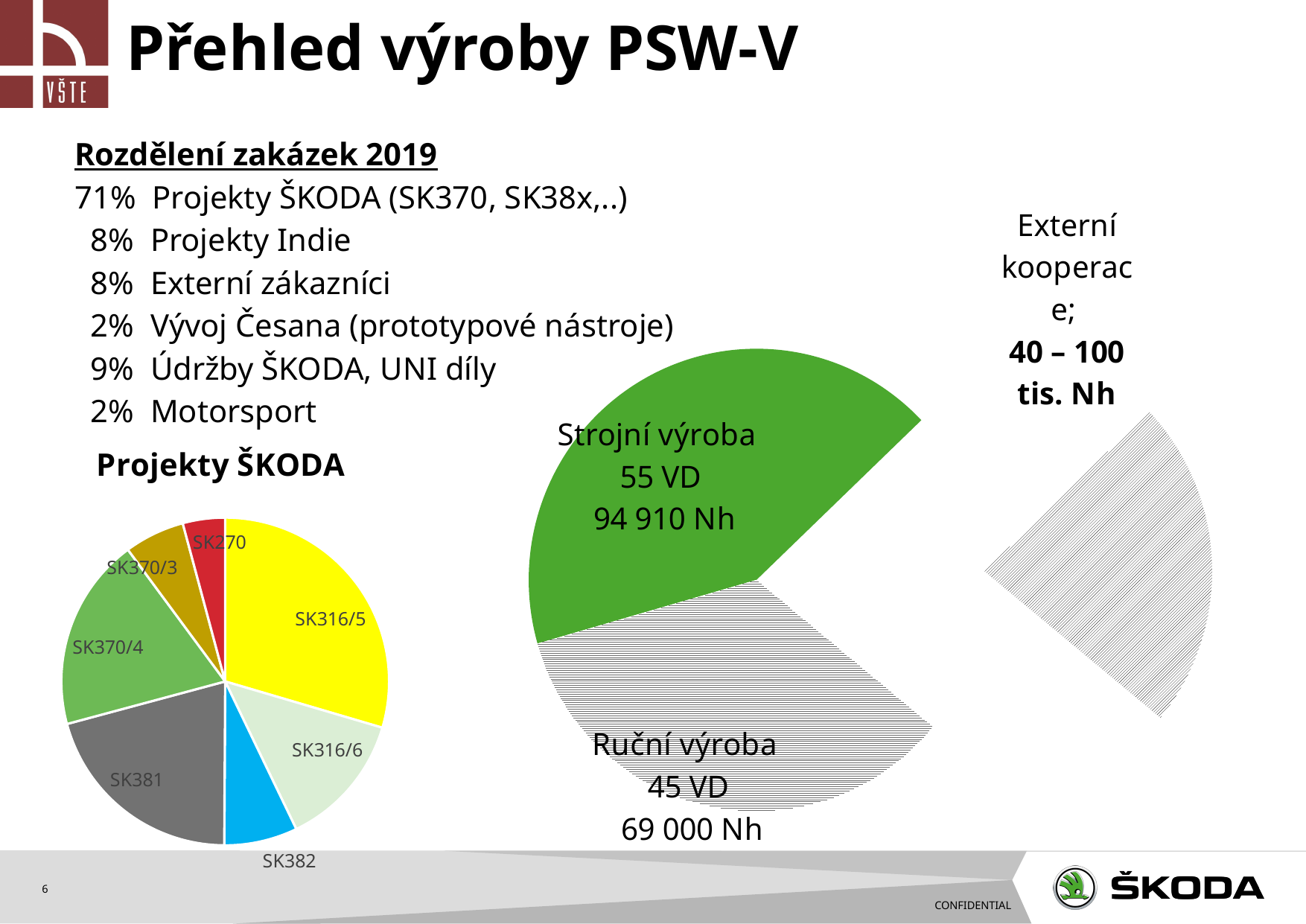
In the 'Projekty ŠKODA' pie chart, what colour is the SK316/5 slice? yellow In the pie chart on the right of the slide, how many hours (Nh) are shown for Ruční výroba? 69 000 Nh How many slices does the 'Projekty ŠKODA' pie chart have? 7 In the pie chart on the right of the slide, what is the difference in Nh between Strojní výroba and Ruční výroba? 25 910 Nh In the 'Projekty ŠKODA' pie chart, which slice is larger, SK381 or SK382? SK381 In the 'Projekty ŠKODA' pie chart, which project has the largest slice? SK316/5 In the pie chart on the right of the slide, how many hours (Nh) are shown for Strojní výroba? 94 910 Nh In the 'Projekty ŠKODA' pie chart, which project has the smallest slice? SK270 In the pie chart on the right of the slide, how many VD are shown for Ruční výroba? 45 VD What kind of chart is the 'Projekty ŠKODA' chart on the left of the slide? pie chart In the pie chart on the right of the slide, which has more VD, Strojní výroba or Ruční výroba? Strojní výroba In the pie chart on the right of the slide, what range of hours is given for Externí kooperace? 40 – 100 tis. Nh